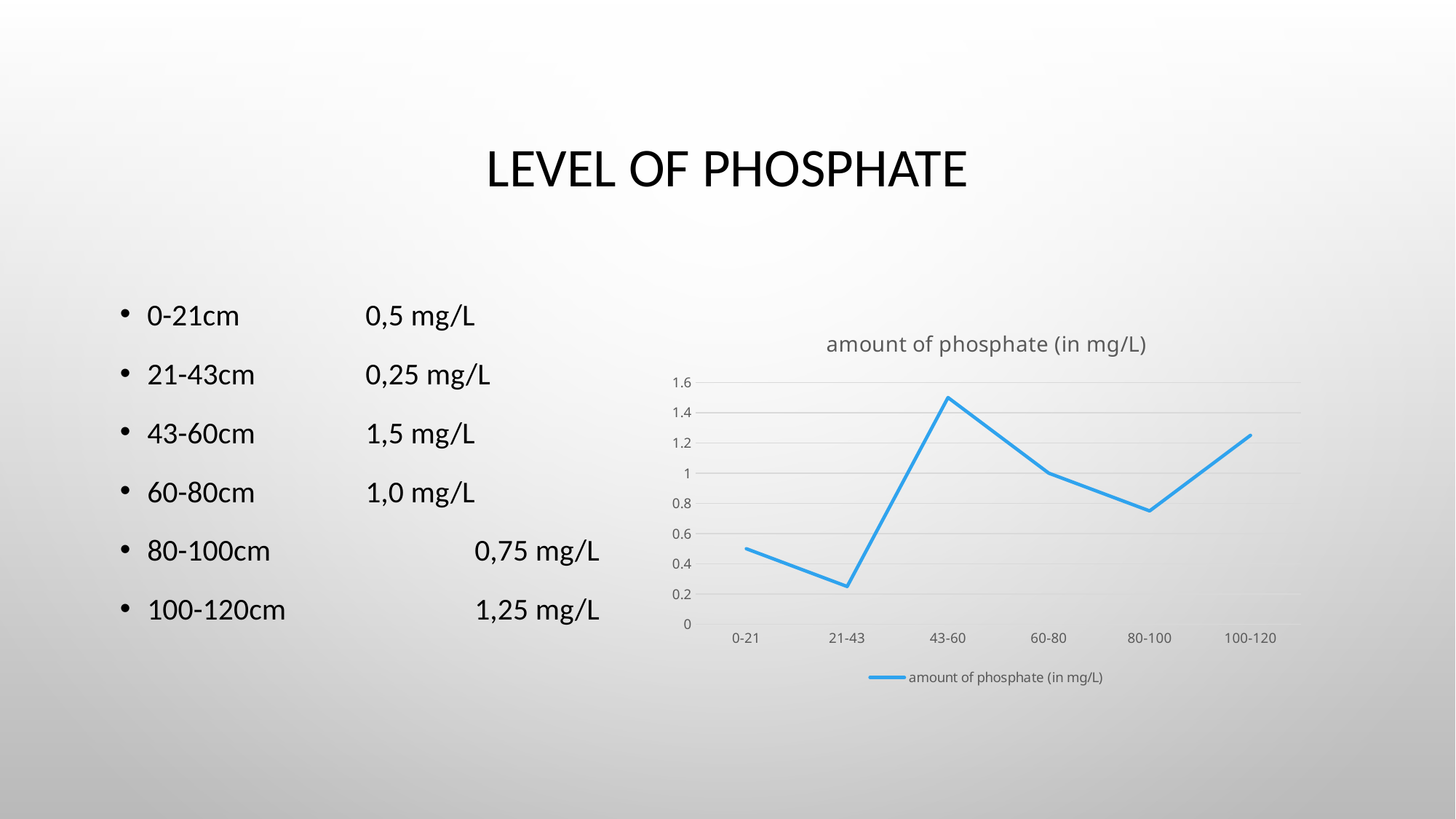
According to the slide, what is the amount of phosphate for the 43-60cm depth range? 1,5 mg/L Is the value for 43-60 in the chart greater or less than 1.4? greater Is the value for 80-100 in the chart greater or less than 1? less Which has a higher amount of phosphate in the chart, 0-21 or 100-120? 100-120 What kind of chart is shown on the slide? line chart According to the slide, what is the amount of phosphate for the 100-120cm depth range? 1,25 mg/L What is the title of the chart? amount of phosphate (in mg/L) Which depth range has the lowest amount of phosphate in the chart? 21-43 How many series does the chart legend list? 1 Which depth range has the highest amount of phosphate in the chart? 43-60 How many depth categories are plotted along the x axis of the chart? 6 What is the amount of phosphate plotted for the 60-80 depth range? 1